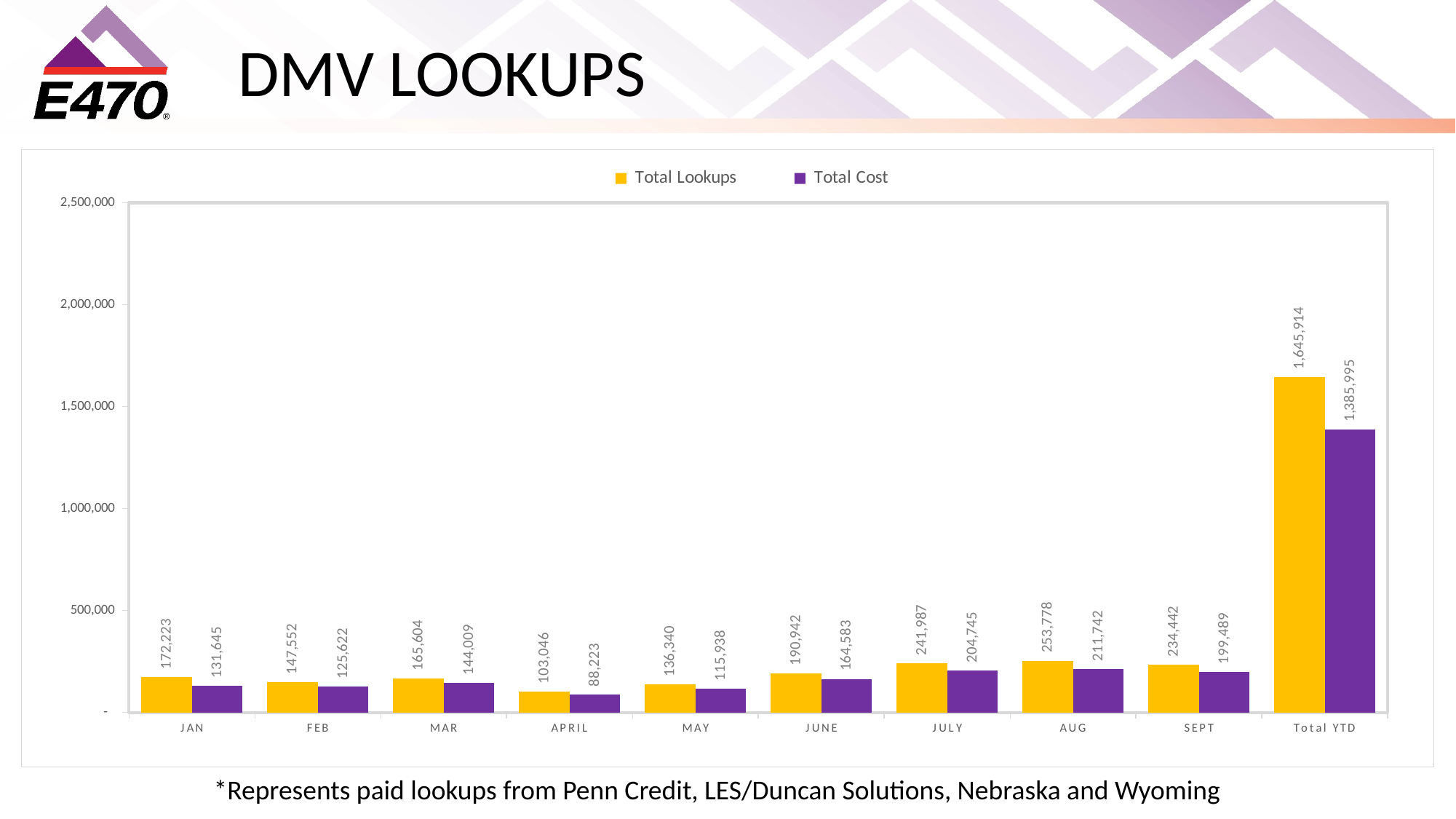
Which has the larger Total Lookups value, JULY or SEPT? JULY What kind of chart is shown on the slide? bar chart What is the Total Lookups value for AUG? 253,778 Is the Total Cost value for Total YTD greater or less than 1,500,000? less What is the difference between Total Lookups and Total Cost for JAN? 40,578 How many categories are shown on the x axis? 10 Among the individual months (excluding Total YTD), which month has the highest Total Lookups? AUG How many series does the legend list? 2 What is the difference between Total Lookups and Total Cost for Total YTD? 259,919 Which month has the lowest Total Cost? APRIL What is the Total Cost value for APRIL? 88,223 What is the Total Lookups value for Total YTD? 1,645,914